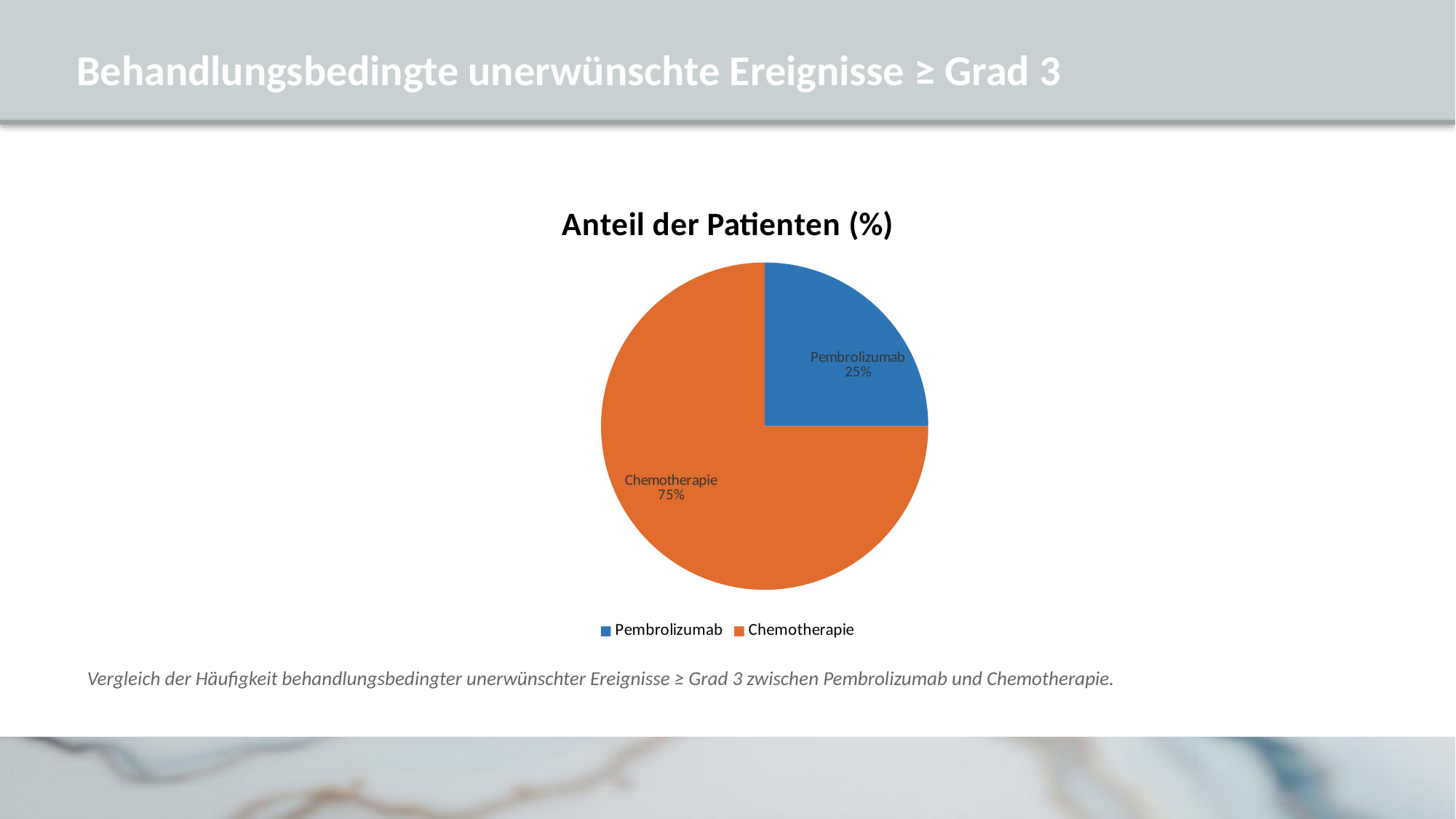
What is the share for Chemotherapie in the pie chart? 75% What colour is the Chemotherapie slice? orange Which category has the smallest slice of the pie? Pembrolizumab How many slices does the pie chart have? 2 Which category has the largest slice of the pie? Chemotherapie What kind of chart is shown on the slide? pie chart Which is larger, the Pembrolizumab slice or the Chemotherapie slice? Chemotherapie What is the difference in percentage points between the Chemotherapie and Pembrolizumab slices? 50 What is the title of the chart? Anteil der Patienten (%) What is the share for Pembrolizumab in the pie chart? 25% How many entries does the legend list? 2